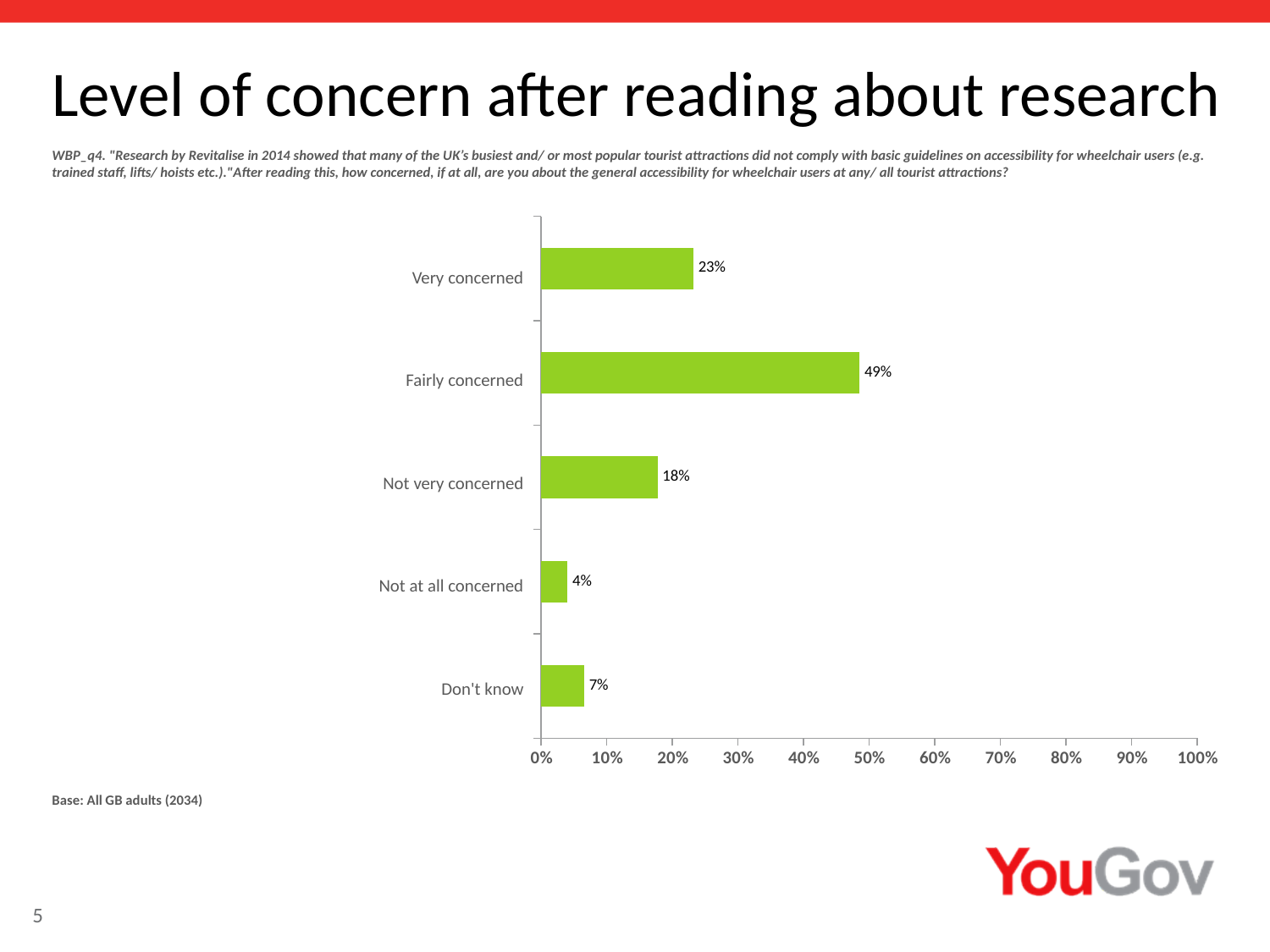
What is the value shown for 'Not at all concerned'? 4% What is the difference between the 'Fairly concerned' and 'Very concerned' values? 26% What is the combined value of 'Very concerned' and 'Fairly concerned'? 72% What type of chart is shown on the slide? Bar chart Which is larger: the value for 'Very concerned' or 'Not very concerned'? Very concerned What percentage of respondents said they were 'Fairly concerned'? 49% Which category has the highest value? Fairly concerned Is the value for 'Fairly concerned' greater or less than 40%? greater What percentage of respondents answered 'Don't know'? 7% How many categories are shown in the chart? 5 What is the highest value shown on the x axis? 100% Which category has the lowest value? Not at all concerned